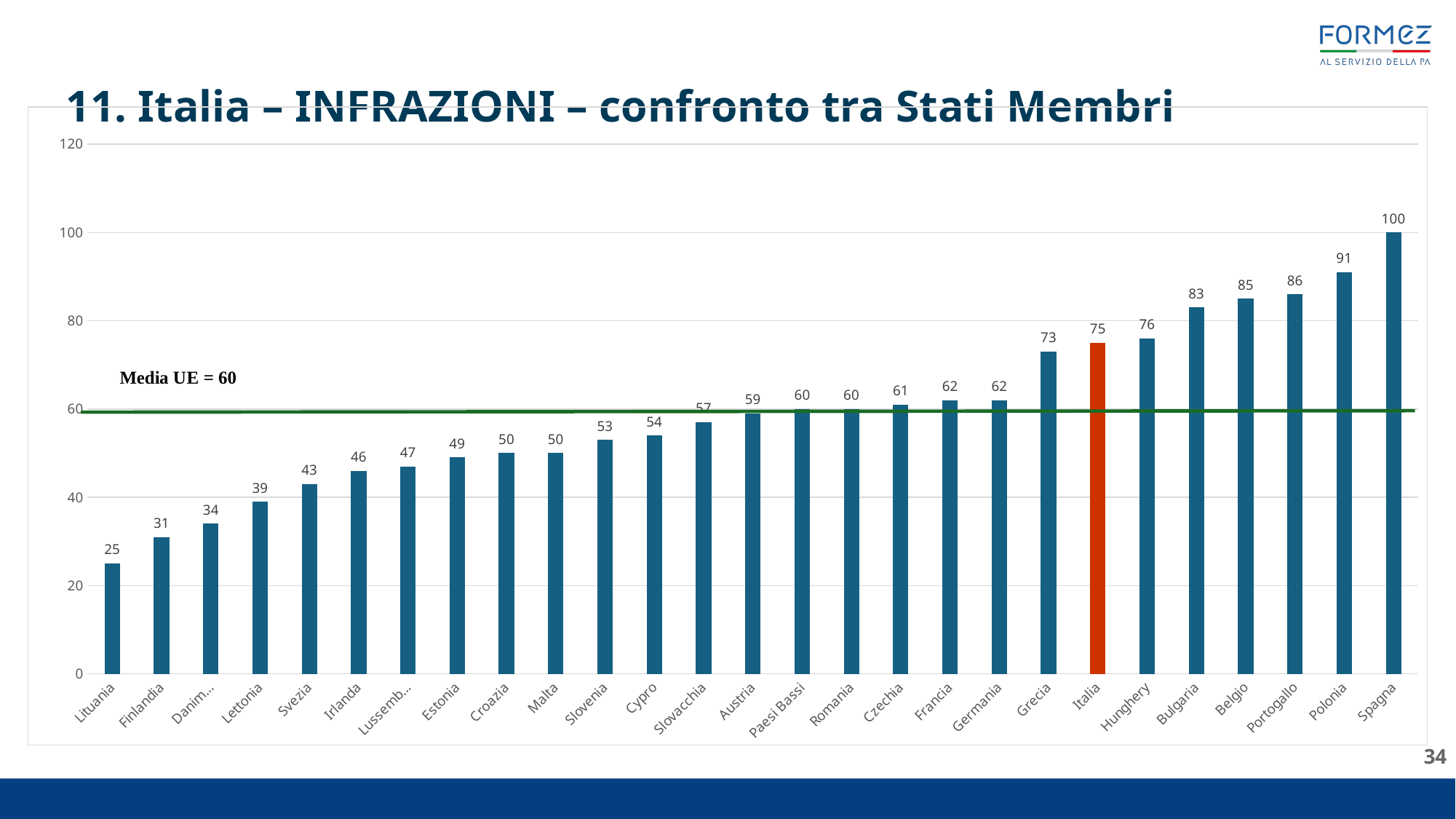
What kind of chart is shown on the slide? bar chart Is the value for Bulgaria greater or less than 80? greater How many countries are shown in the chart? 27 What is the value for Lituania? 25 Do the values rise or fall from left to right along the x axis? rise What is the value for Italia? 75 What is the difference between the values for Spagna and Italia? 25 Which country has the lowest value? Lituania What value does the horizontal green line labelled 'Media UE' represent? 60 What is the value for Grecia? 73 Which is larger, the value for Polonia or the value for Portogallo? Polonia Which country has the highest value? Spagna